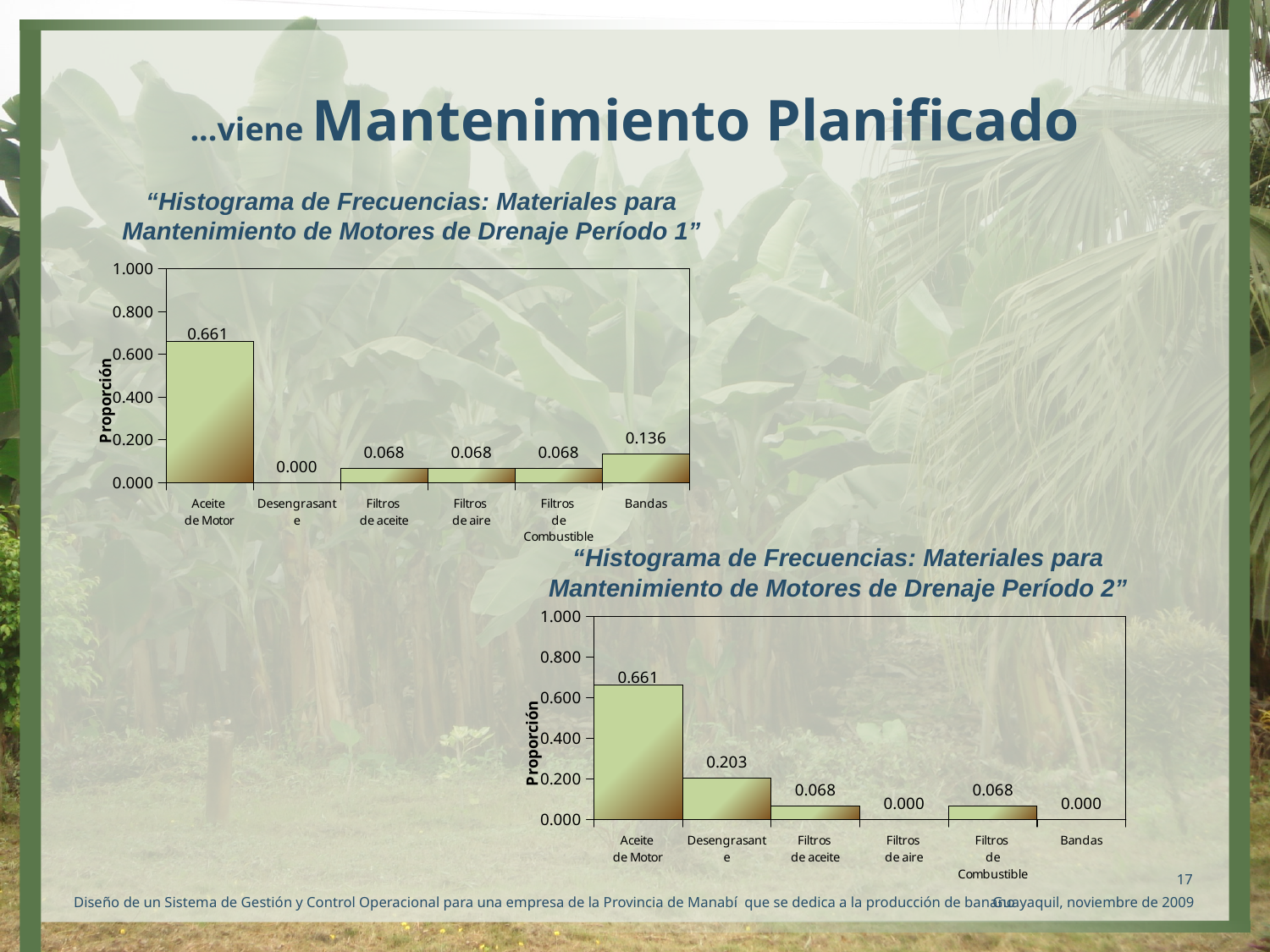
How many categories are shown on the x axis of the Período 2 chart? 6 In the Período 1 chart, which category has the highest proportion? Aceite de Motor In the Período 1 chart, which category has the lowest proportion? Desengrasante In the Período 2 chart, what is the proportion for Desengrasante? 0.203 In the Período 2 chart, what is the difference between the proportions for Aceite de Motor and Desengrasante? 0.458 In the Período 2 chart, what is the proportion for Filtros de aire? 0.000 What is the y-axis label of the Período 2 chart? Proporción In the Período 1 chart, what is the proportion for Bandas? 0.136 In the Período 1 chart, what is the difference between the proportions for Bandas and Filtros de aire? 0.068 In the Período 1 chart, what is the proportion for Aceite de Motor? 0.661 What kind of chart is the Período 1 chart? Bar chart In the Período 2 chart, which is larger: the proportion for Desengrasante or for Filtros de aceite? Desengrasante